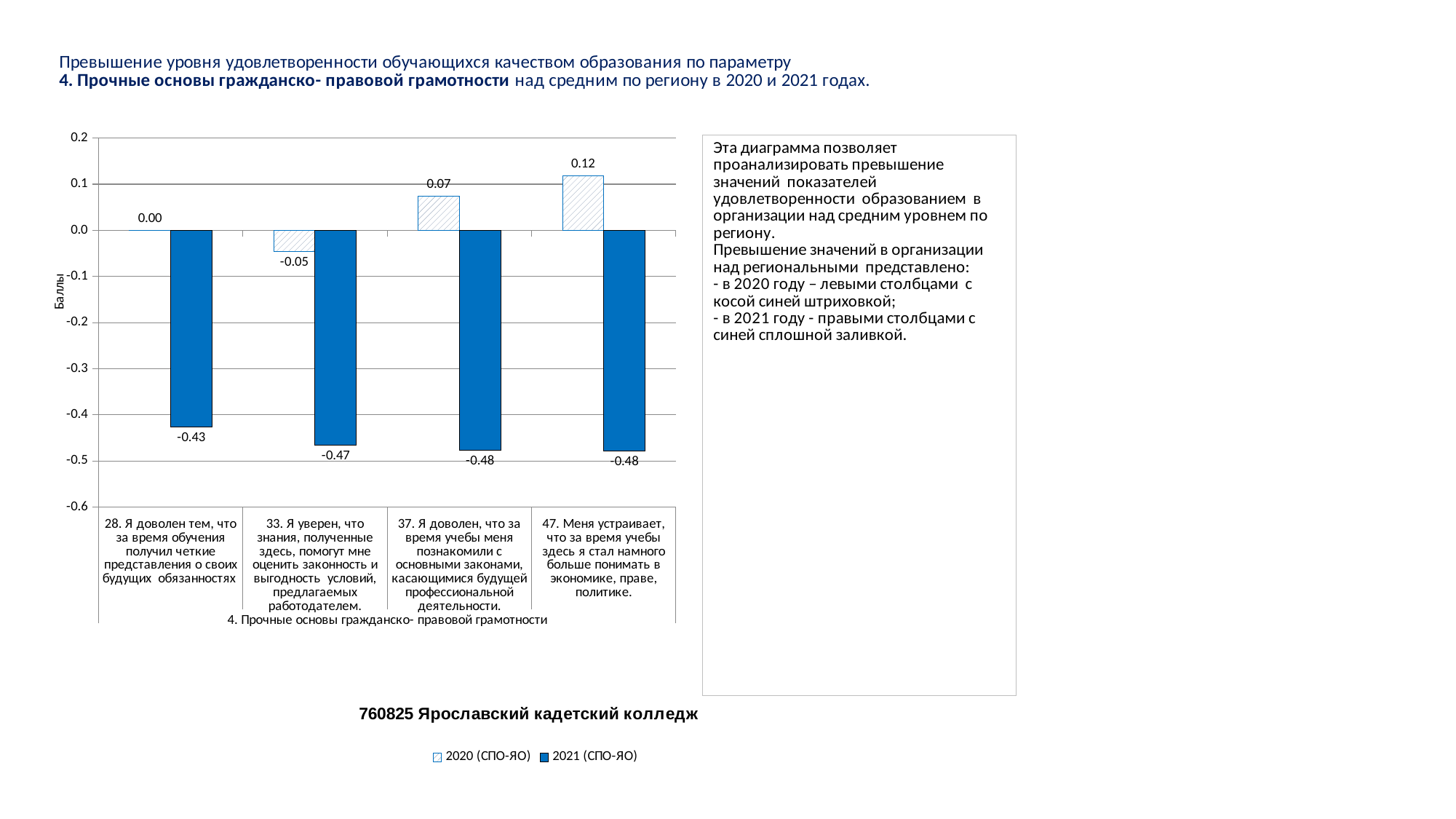
What is the value of the 2020 (СПО-ЯО) series for category 33 (Я уверен, что знания, полученные здесь, помогут мне оценить законность и выгодность условий, предлагаемых работодателем)? -0.05 How many series does the chart legend list? 2 Which category has the highest value in the 2020 (СПО-ЯО) series? 47. Меня устраивает, что за время учебы здесь я стал намного больше понимать в экономике, праве, политике. What is the value of the 2020 (СПО-ЯО) series for category 47 (Меня устраивает, что за время учебы здесь я стал намного больше понимать в экономике, праве, политике)? 0.12 What is the value of the 2021 (СПО-ЯО) series for category 37 (Я доволен, что за время учебы меня познакомили с основными законами, касающимися будущей профессиональной деятельности)? -0.48 Which category has the lowest value in the 2020 (СПО-ЯО) series? 33. Я уверен, что знания, полученные здесь, помогут мне оценить законность и выгодность условий, предлагаемых работодателем. For category 37, which series has the larger value: 2020 (СПО-ЯО) or 2021 (СПО-ЯО)? 2020 (СПО-ЯО) Which category has the highest value in the 2021 (СПО-ЯО) series? 28. Я доволен тем, что за время обучения получил четкие представления о своих будущих обязанностях What is the value of the 2021 (СПО-ЯО) series for category 28 (Я доволен тем, что за время обучения получил четкие представления о своих будущих обязанностях)? -0.43 How many categories are shown on the x axis of the chart? 4 What type of chart is shown on the slide? Bar chart What is the difference between the 2020 (СПО-ЯО) and 2021 (СПО-ЯО) values for category 47? 0.60